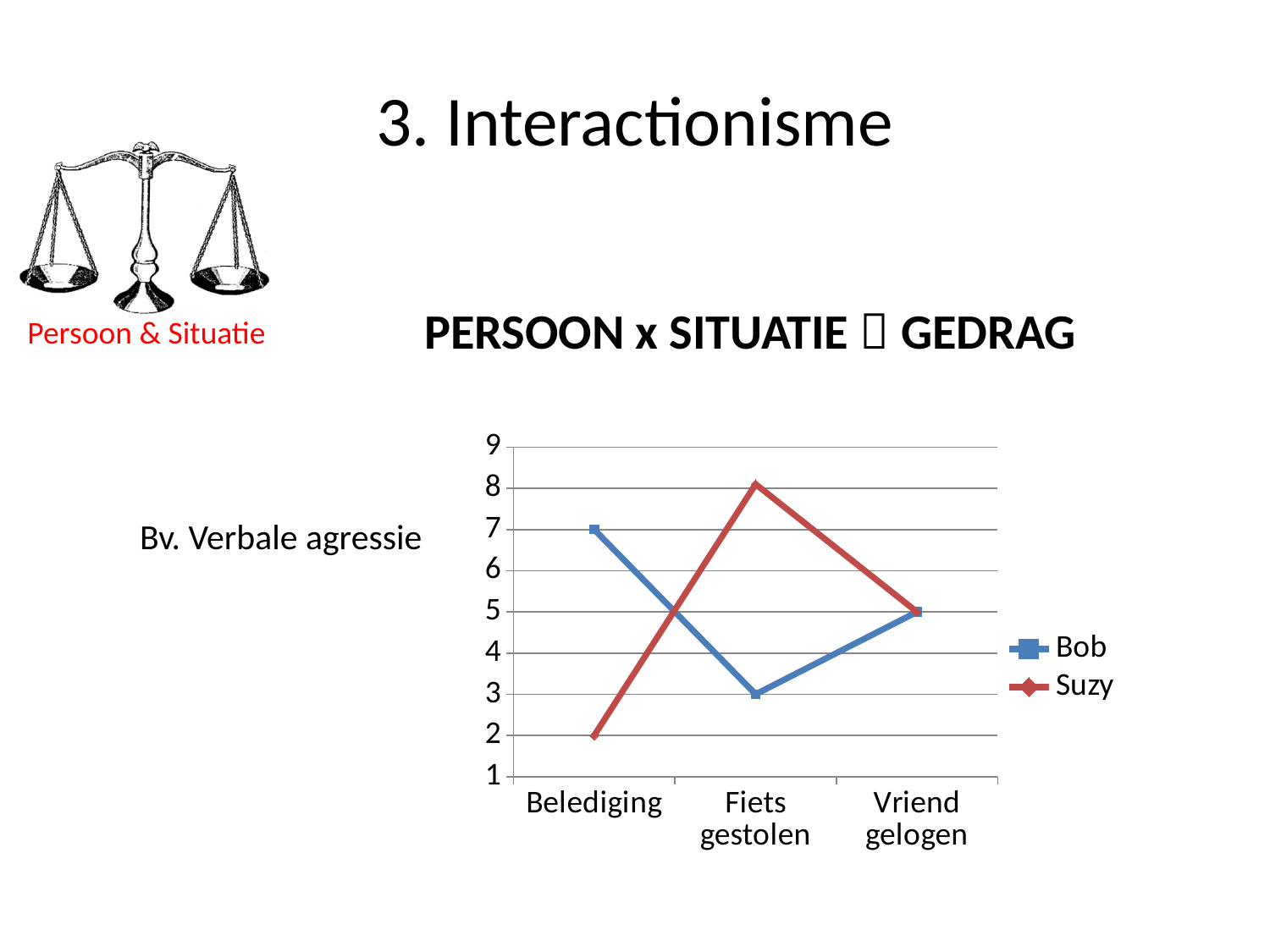
What is the difference between Bob's value at Belediging and his value at Fiets gestolen? 4 What is the value for Suzy at Belediging? 2 How many series does the chart's legend list? 2 For which category is Bob's value highest? Belediging For which category is Suzy's value lowest? Belediging What is the value for Bob at Vriend gelogen? 5 What is the value for Bob at Belediging? 7 What kind of chart is shown on the slide? line chart At Belediging, who has the higher value, Bob or Suzy? Bob What is the value for Bob at Fiets gestolen? 3 How many categories are shown on the x axis of the chart? 3 Is the value for Suzy at Fiets gestolen greater or less than 7? greater